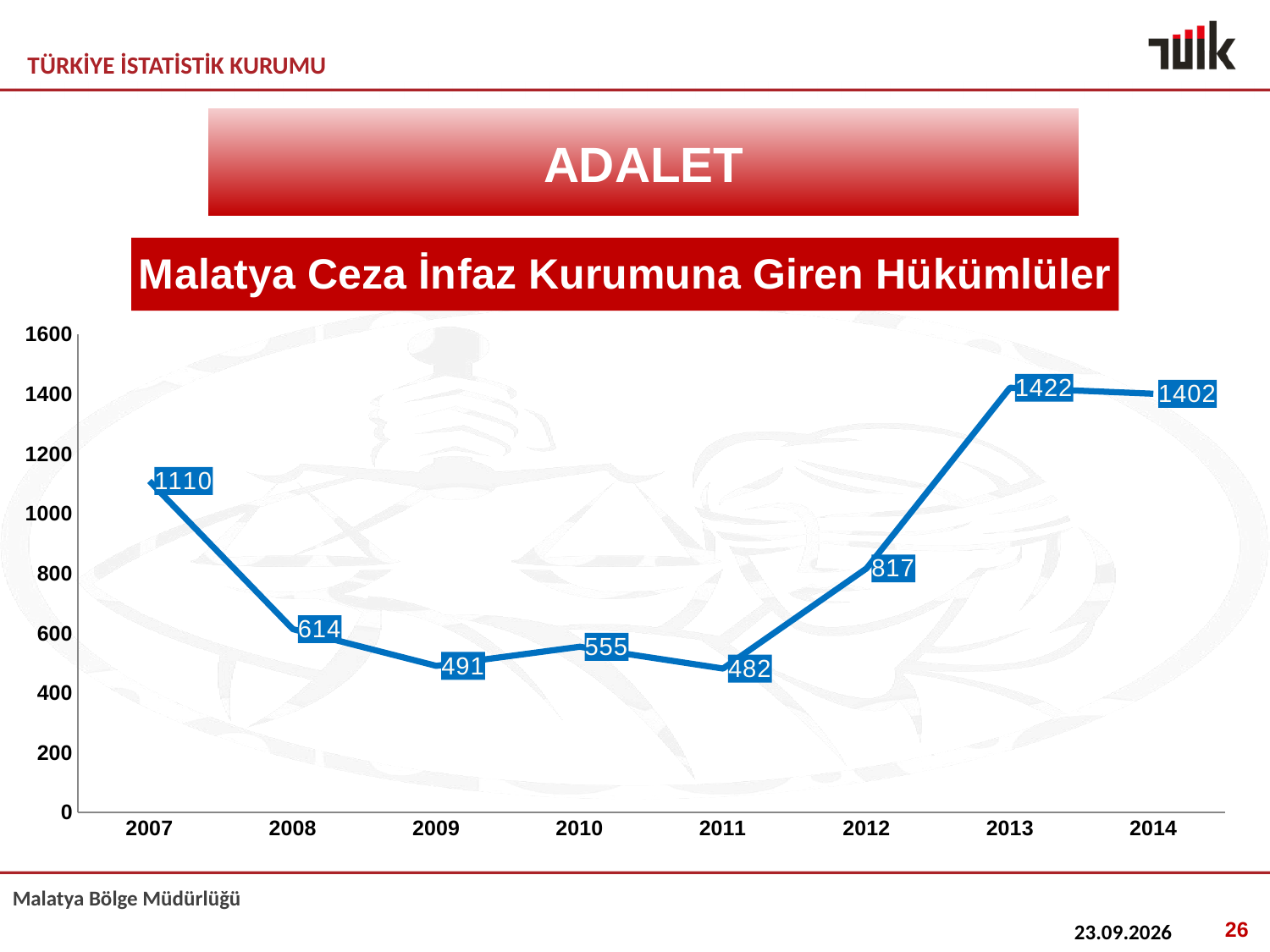
Do the values rise or fall from 2011 to 2013? rise Which is larger, the value for 2008 or the value for 2010? 2008 What is the title of the chart? Malatya Ceza İnfaz Kurumuna Giren Hükümlüler Which year has the lowest value? 2011 Is the value for 2009 greater or less than 600? less How many years are shown on the x axis? 8 What is the value for 2014? 1402 What is the value for 2011? 482 What is the difference between the values for 2013 and 2012? 605 What is the value for 2007? 1110 What kind of chart is this? line chart Which year has the highest value? 2013